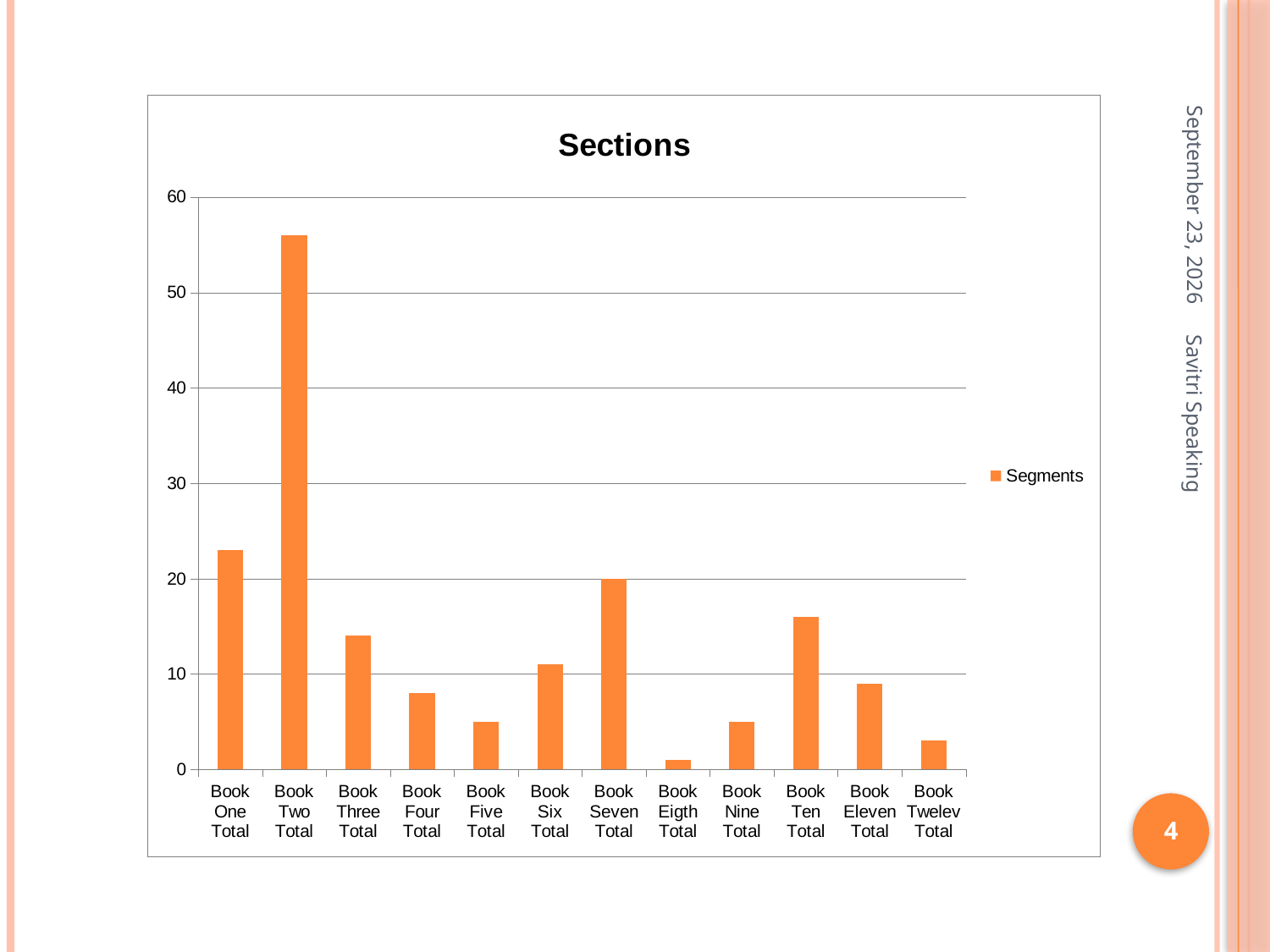
Is the value for Book One Total greater or less than 20? greater What is the title of the chart? Sections What type of chart is shown on the slide? bar chart Which is larger, the value for Book Three Total or the value for Book Six Total? Book Three Total Which category has the lowest value? Book Eigth Total Which is larger, the value for Book Ten Total or the value for Book Eleven Total? Book Ten Total How many categories are plotted on the x axis? 12 Is the value for Book Four Total greater or less than 10? less How many series does the legend list? 1 Is the value for Book Two Total greater or less than 50? greater Which category has the highest value? Book Two Total What is the name of the series shown in the legend? Segments